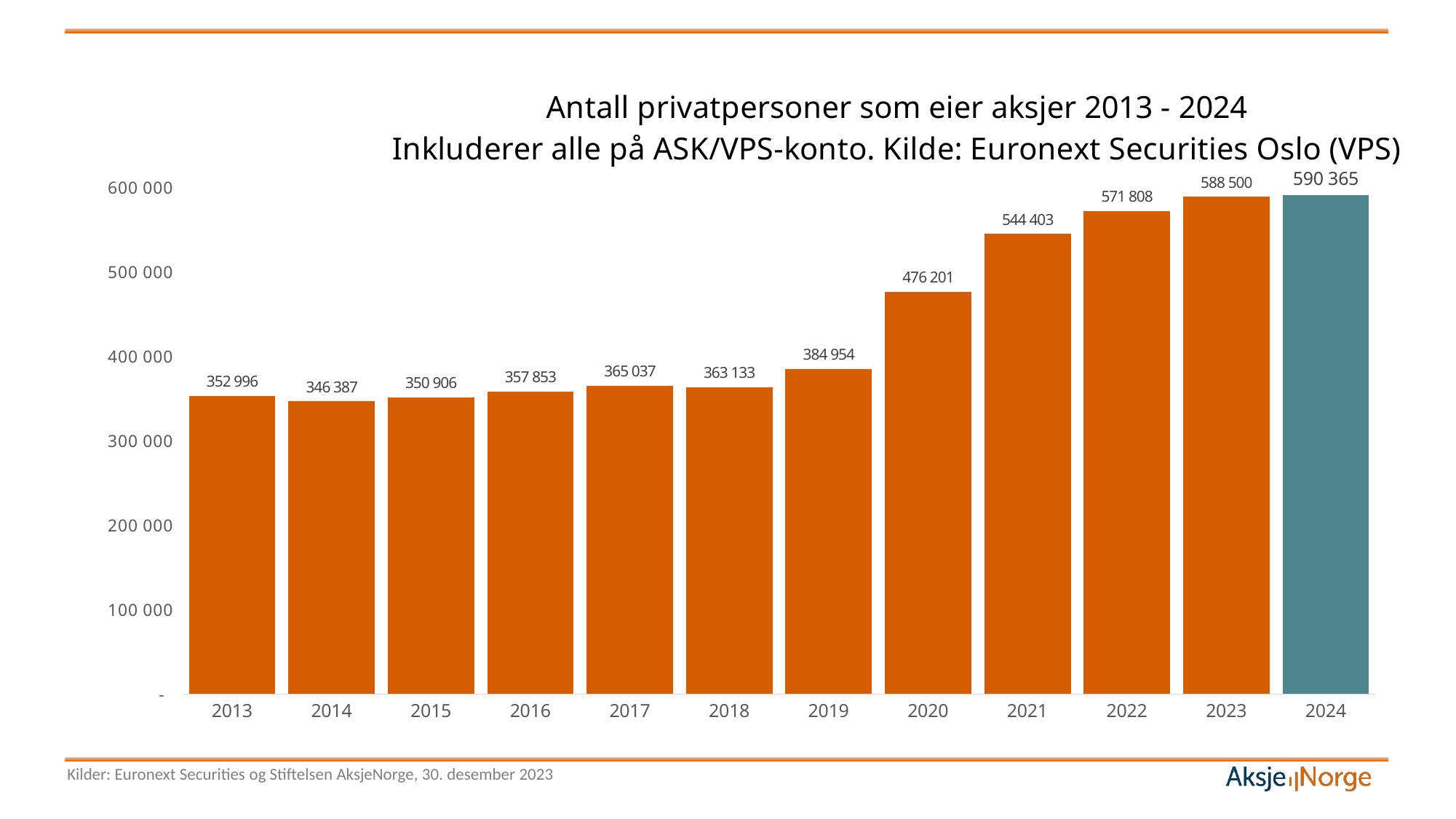
What kind of chart is this? bar chart Is the value for 2021 greater or less than 500 000? greater What is the value for 2020? 476 201 Which year has the lowest value? 2014 How many years are shown on the x axis? 12 Which year has the highest value? 2024 What is the difference between the values for 2020 and 2019? 91 247 What is the value for 2024? 590 365 Do the values generally rise or fall from 2018 to 2024? rise Which is larger, the value for 2017 or the value for 2018? 2017 What is the value for 2013? 352 996 What is the difference between the values for 2024 and 2023? 1 865